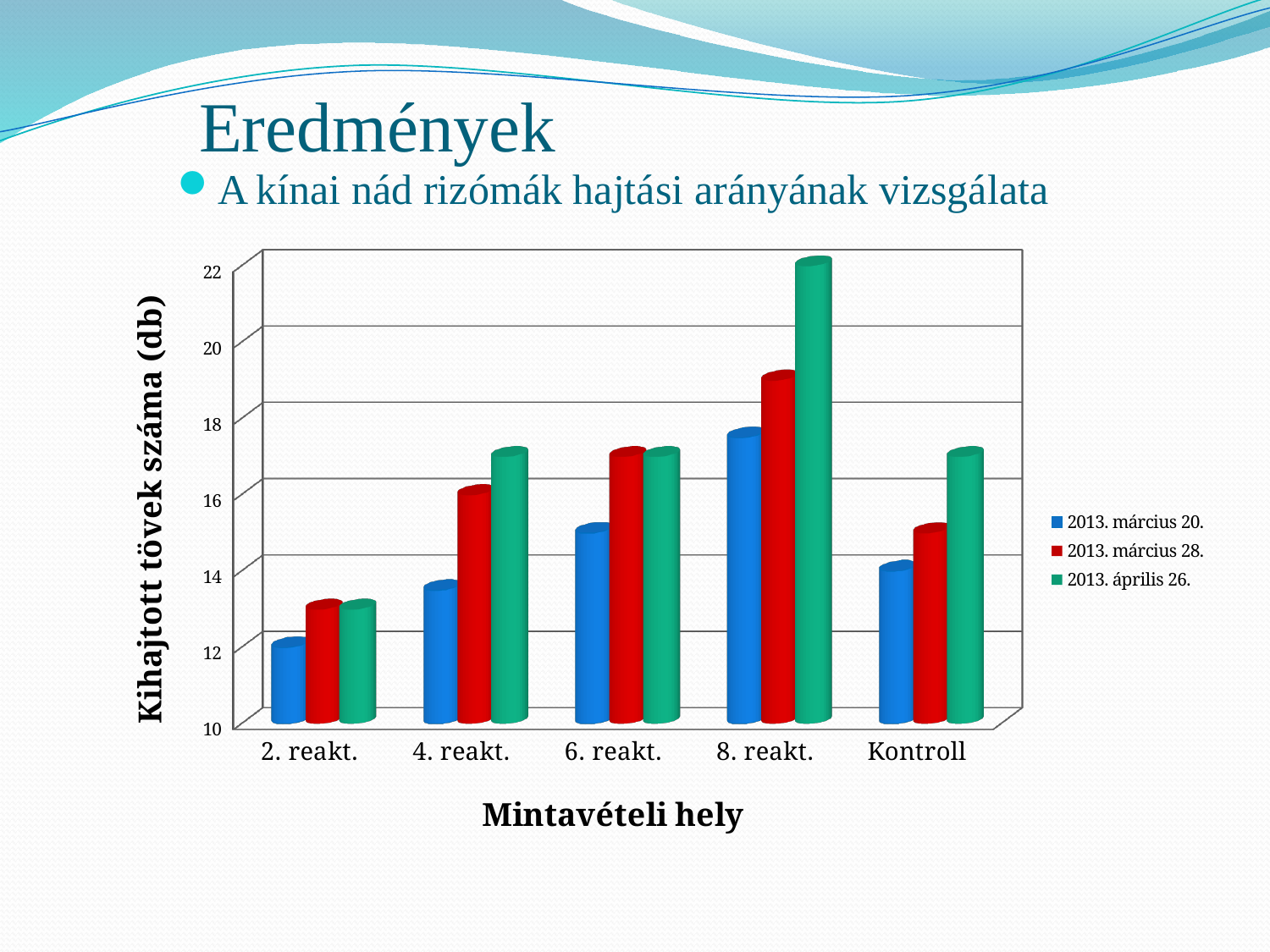
What kind of chart is shown on the slide? bar chart What is the title of the chart's vertical axis? Kihajtott tövek száma (db) Is the value for 8. reakt. in the 2013. április 26. series greater or less than 20? greater Is the value for 4. reakt. in the 2013. március 20. series greater or less than 14? less Which category has the highest bar for the 2013. március 28. series? 8. reakt. Is the value for 6. reakt. in the 2013. március 28. series greater or less than 16? greater Which category has the lowest bar for the 2013. március 20. series? 2. reakt. How many series does the chart's legend list? 3 How many categories are shown on the x axis of the chart? 5 For 8. reakt., which is larger: the 2013. április 26. value or the 2013. március 28. value? 2013. április 26. Which category has the highest bar for the 2013. április 26. series? 8. reakt. For Kontroll, which is larger: the 2013. március 20. value or the 2013. április 26. value? 2013. április 26.